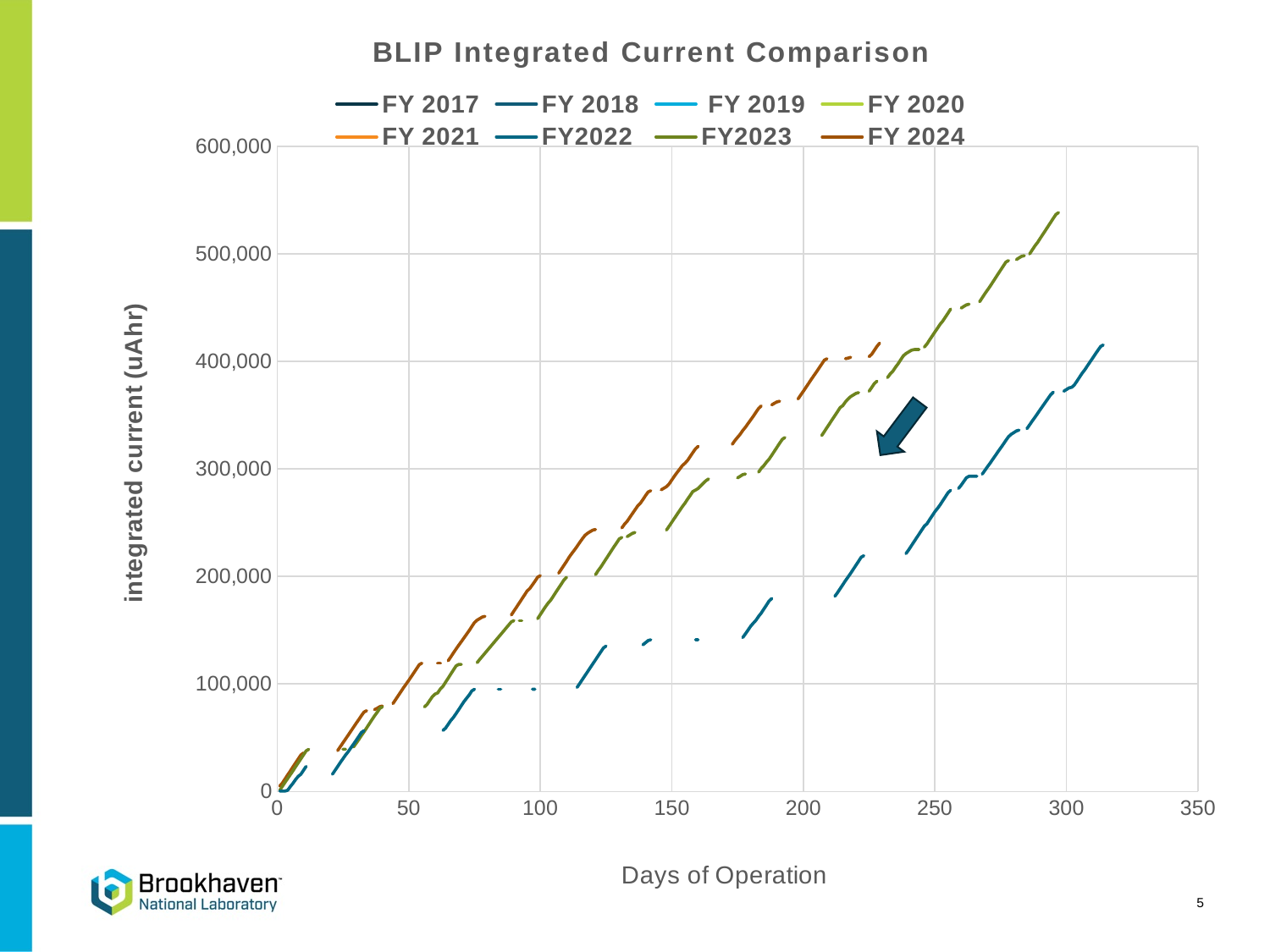
At 200 days of operation, which line is higher: FY 2024 or FY2022? FY 2024 What kind of chart is shown on the slide? line chart Which series reaches the highest integrated current on the chart? FY2023 How many series does the legend list? 8 Do the plotted lines rise or fall as Days of Operation increase? rise At 150 days of operation, which line is higher: FY2023 or FY2022? FY2023 What is the label of the vertical axis? integrated current (uAhr) Is the value of the FY 2024 line at 200 days greater or less than 300,000? greater Is the final value of the FY2023 line greater or less than 500,000? greater What is the title of the chart? BLIP Integrated Current Comparison Is the value of the FY2022 line at 300 days greater or less than 400,000? less